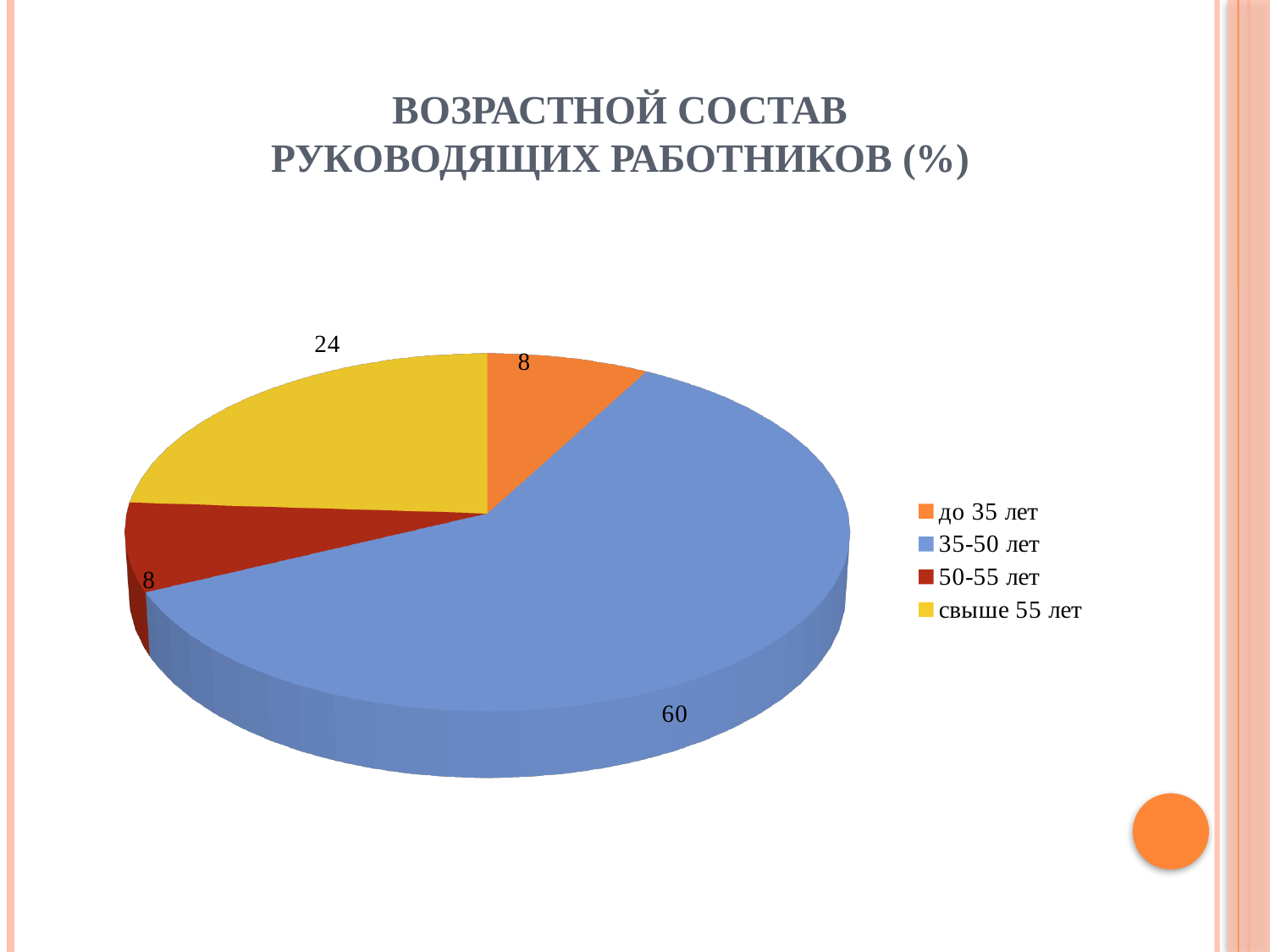
Which colour represents the category "35-50 лет" in the pie chart? blue What is the value for the category "до 35 лет"? 8 Which category has the largest slice of the pie? 35-50 лет What is the value for the category "50-55 лет"? 8 What is the difference between the values for "35-50 лет" and "свыше 55 лет"? 36 What is the difference between the values for "свыше 55 лет" and "до 35 лет"? 16 Which is larger, the value for "свыше 55 лет" or the value for "50-55 лет"? свыше 55 лет How many categories are shown in the pie chart? 4 What is the value for the category "свыше 55 лет"? 24 What type of chart is shown on the slide? pie chart What is the value for the category "35-50 лет"? 60 What is the title of the chart? ВОЗРАСТНОЙ СОСТАВ РУКОВОДЯЩИХ РАБОТНИКОВ (%)